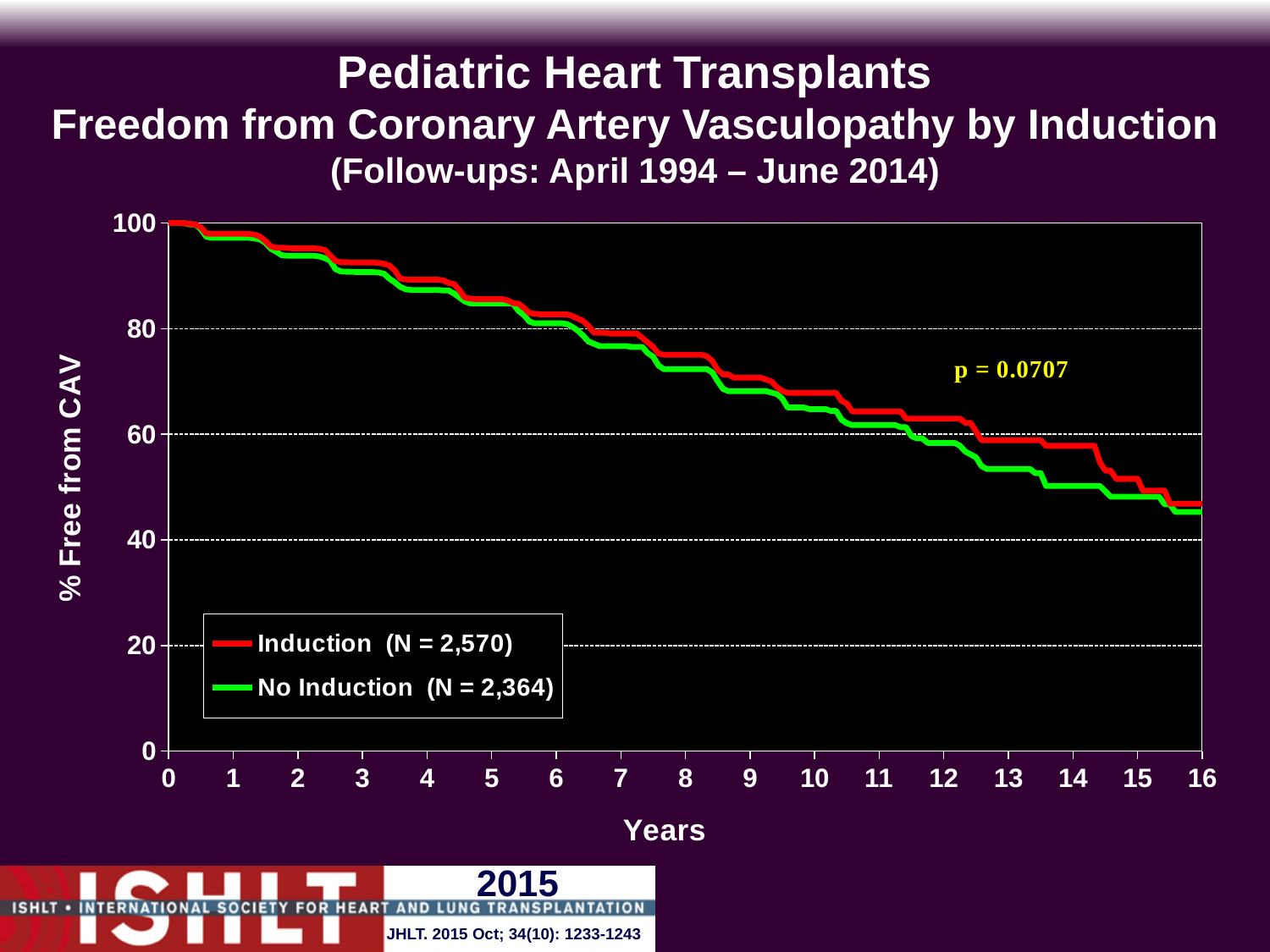
At 10 years, which series has the higher % free from CAV, Induction or No Induction? Induction Is the value for the No Induction series at 14 years greater or less than 60? less At 16 years, which series has the lower % free from CAV, Induction or No Induction? No Induction What is the N for the Induction series shown in the legend? N = 2,570 Is the value for the Induction series at 16 years greater or less than 60? less What p-value is printed on the chart? p = 0.0707 Is the value for the No Induction series at 4 years greater or less than 80? greater What kind of chart is shown on the slide? line chart How many series does the legend list? 2 Do the values for the No Induction series rise or fall along the x axis? fall Do the values for the Induction series rise or fall as years increase? fall